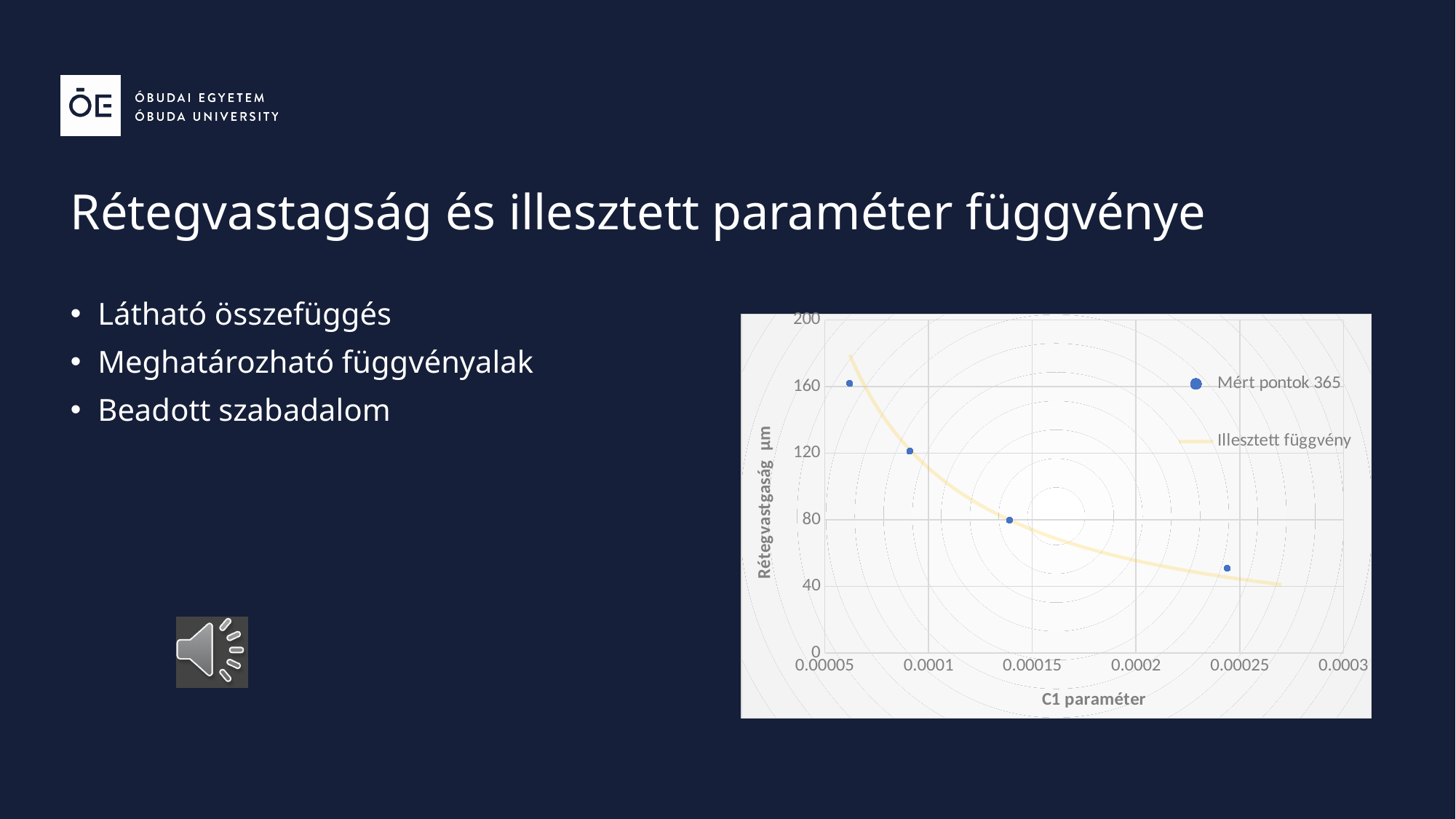
What is the title of the chart's x axis? C1 paraméter How many measured points (Mért pontok 365) are plotted on the chart? 4 Which measured point has the lowest Rétegvastagság value, the leftmost or the rightmost? the rightmost Which measured point has the highest Rétegvastagság value, the leftmost or the rightmost? the leftmost Is the Rétegvastagság value of the leftmost measured point greater or less than 120? greater What is the title of the chart's y axis? Rétegvastagság µm Is the Rétegvastagság value of the rightmost measured point greater or less than 40? greater What kind of chart is shown on the slide? scatter chart How many series does the chart legend list? 2 Do the measured points rise or fall as the C1 paraméter increases along the x axis? fall Is the Rétegvastagság value of the rightmost measured point greater or less than 80? less